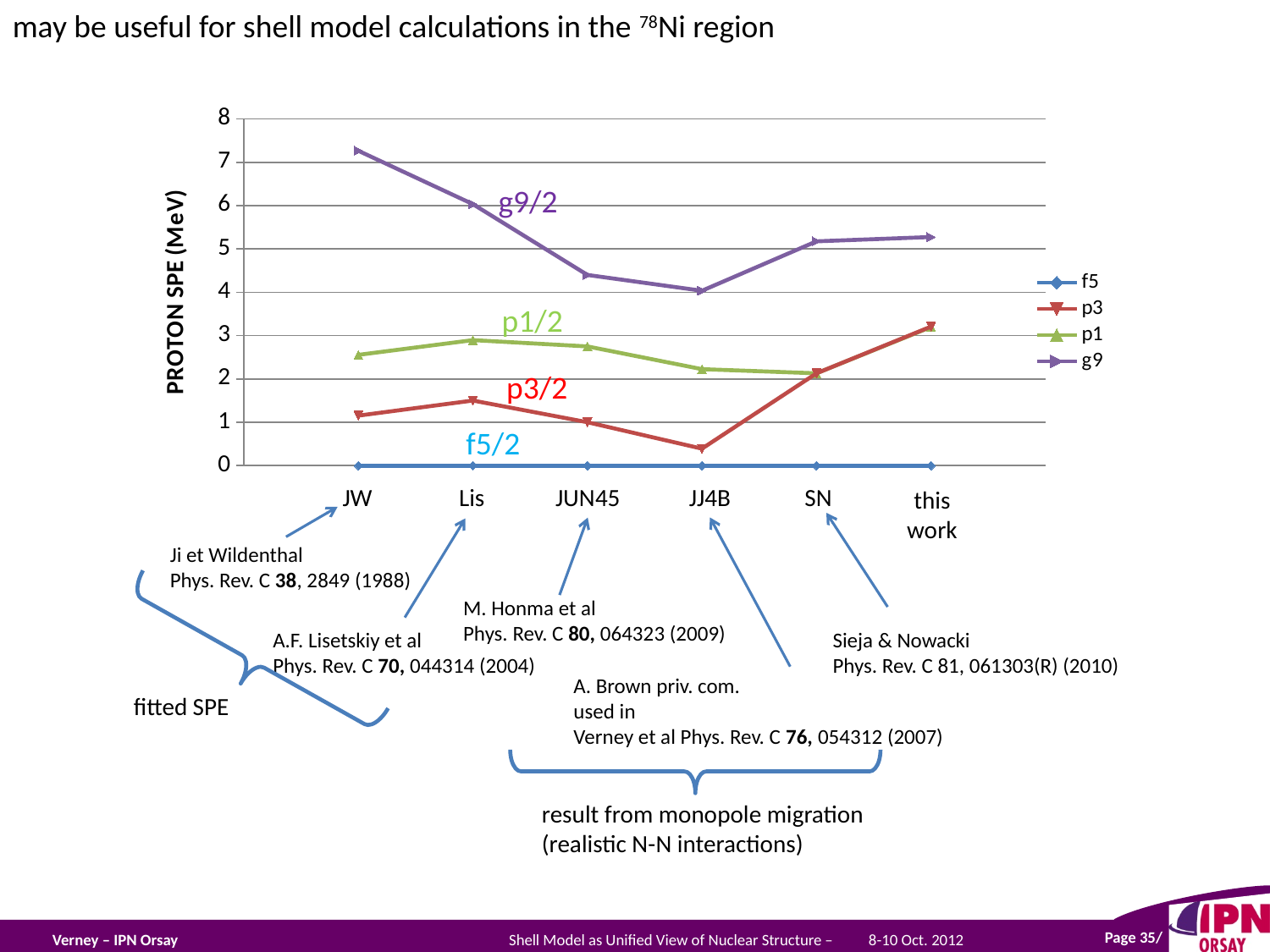
Is the value of g9 at SN greater or less than 5? greater For which category is the g9 series highest? JW How many categories are shown along the x axis? 6 Is the value of g9 at JW greater or less than 7? greater Is the value of p3 at JJ4B greater or less than 1? less Does the g9 series rise or fall from JW to JJ4B? fall What is the value of the f5 series at JUN45? 0 What kind of chart is shown on the slide? line chart For which category is the p3 series lowest? JJ4B For which category is the g9 series lowest? JJ4B Which series has the larger value at JW, g9 or p1? g9 How many series does the legend list? 4